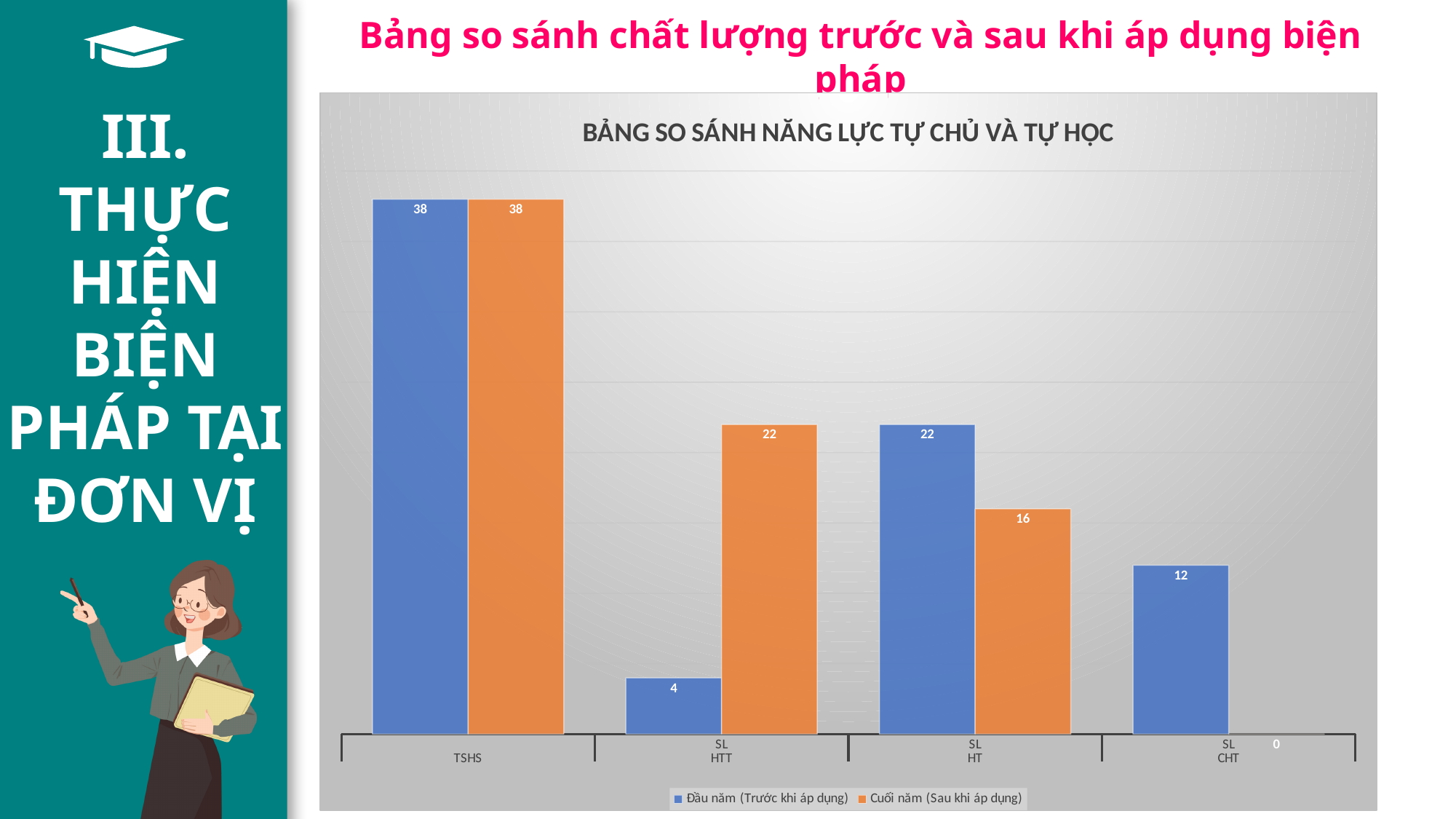
Which category has the lowest value in the Đầu năm (Trước khi áp dụng) series? SL HTT What is the value for SL CHT in the Cuối năm (Sau khi áp dụng) series? 0 What is the difference between the Đầu năm and Cuối năm values for SL HT? 6 What is the value for SL HTT in the Cuối năm (Sau khi áp dụng) series? 22 What is the value for SL HT in the Cuối năm (Sau khi áp dụng) series? 16 How many series does the legend list? 2 What is the difference between the Cuối năm and Đầu năm values for SL HTT? 18 What is the value for SL HTT in the Đầu năm (Trước khi áp dụng) series? 4 Which category has the highest value in the Cuối năm (Sau khi áp dụng) series? TSHS What type of chart is shown on the slide? Bar chart For SL HT, which series has the larger value, Đầu năm (Trước khi áp dụng) or Cuối năm (Sau khi áp dụng)? Đầu năm (Trước khi áp dụng) How many categories are shown on the x axis? 4